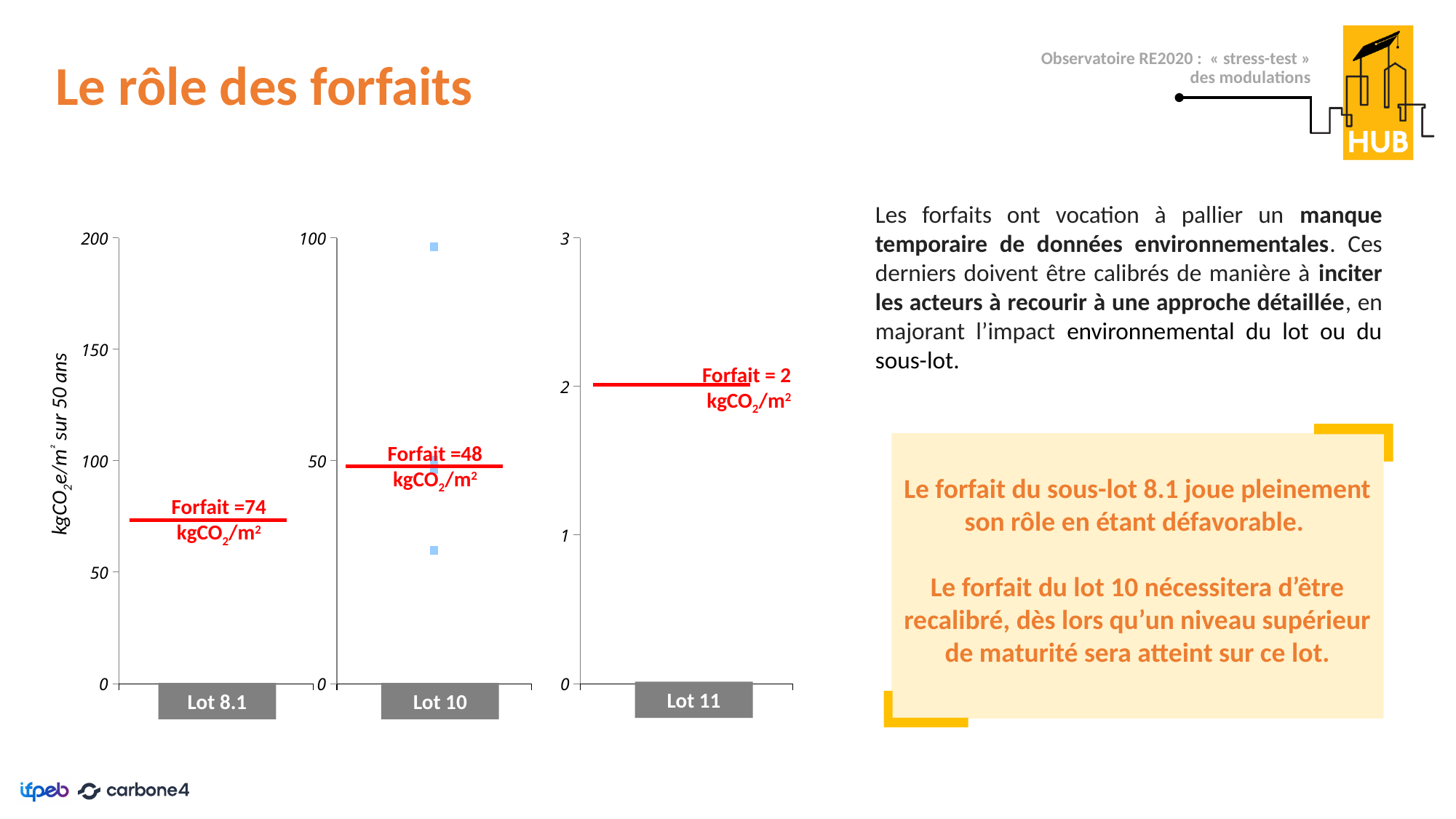
On the Lot 11 chart, what is the forfait value shown by the red line? 2 kgCO2/m² What is the y-axis label of the Lot 8.1 chart? kgCO2e/m² sur 50 ans What is the difference between the forfait for Lot 8.1 and the forfait for Lot 10? 26 kgCO2/m² Across the three charts, which lot has the lowest forfait value? Lot 11 On the Lot 10 chart, what is the forfait value shown by the red line? 48 kgCO2/m² On the Lot 10 chart, is the lowest blue data point greater or less than 50? less Across the three charts, which lot has the highest forfait value? Lot 8.1 What is the maximum value on the y axis of the Lot 11 chart? 3 Which is larger, the forfait for Lot 10 or the forfait for Lot 11? Lot 10 How many lot charts are shown on the slide? 3 On the Lot 8.1 chart, what is the forfait value shown by the red line? 74 kgCO2/m² On the Lot 10 chart, is the highest blue data point greater or less than 50? greater